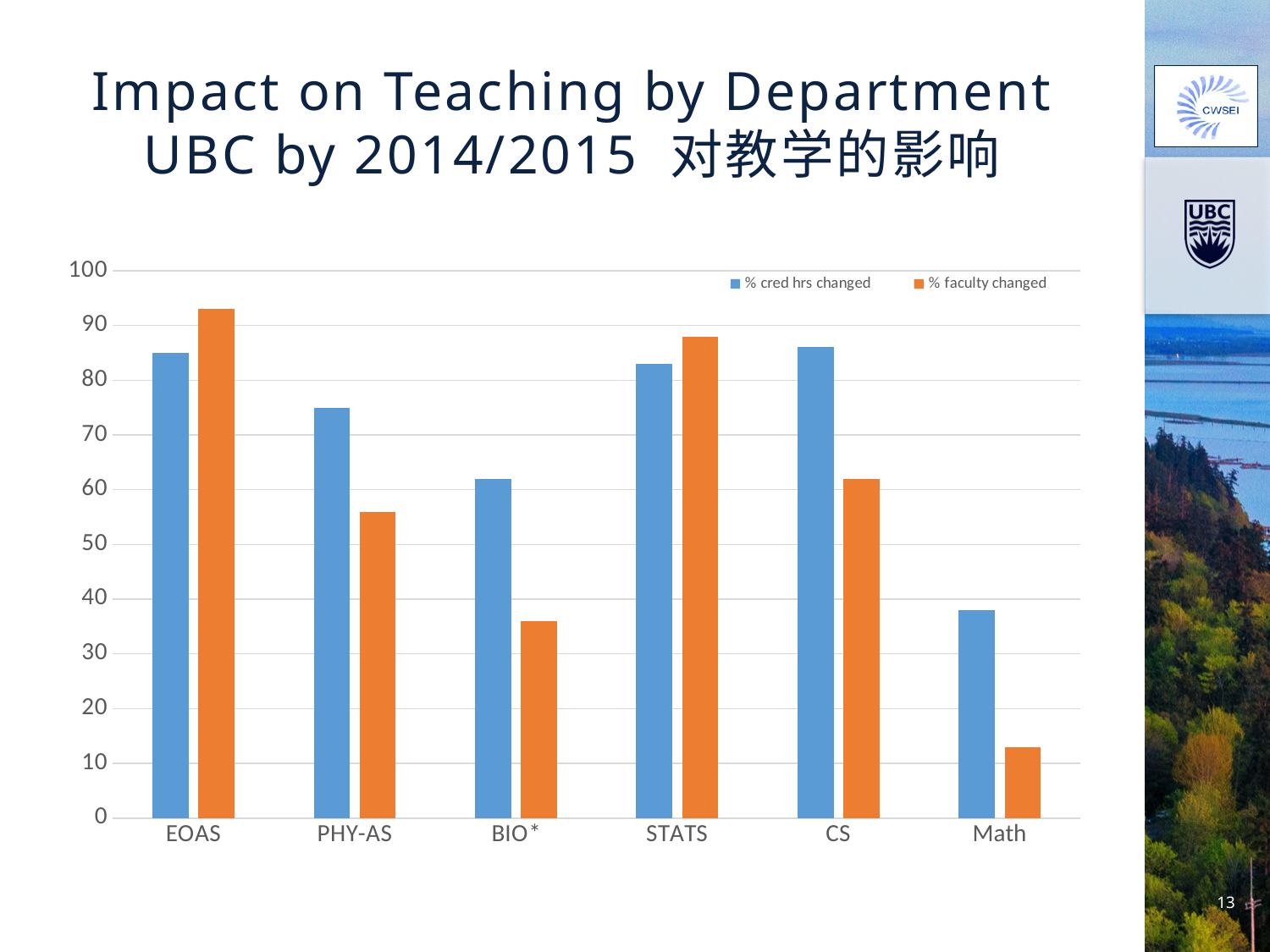
Is the value for % faculty changed for BIO* greater or less than 40? less Which department has the lowest value for % cred hrs changed? Math For EOAS, which is larger: % cred hrs changed or % faculty changed? % faculty changed Which department has the highest value for % faculty changed? EOAS How many series does the chart's legend list? 2 Is the value for % faculty changed for Math greater or less than 20? less For Math, which is larger: % cred hrs changed or % faculty changed? % cred hrs changed What kind of chart is shown on the slide? bar chart How many departments are shown on the x axis of the chart? 6 Is the value for % cred hrs changed for EOAS greater or less than 80? greater Which department has the lowest value for % faculty changed? Math